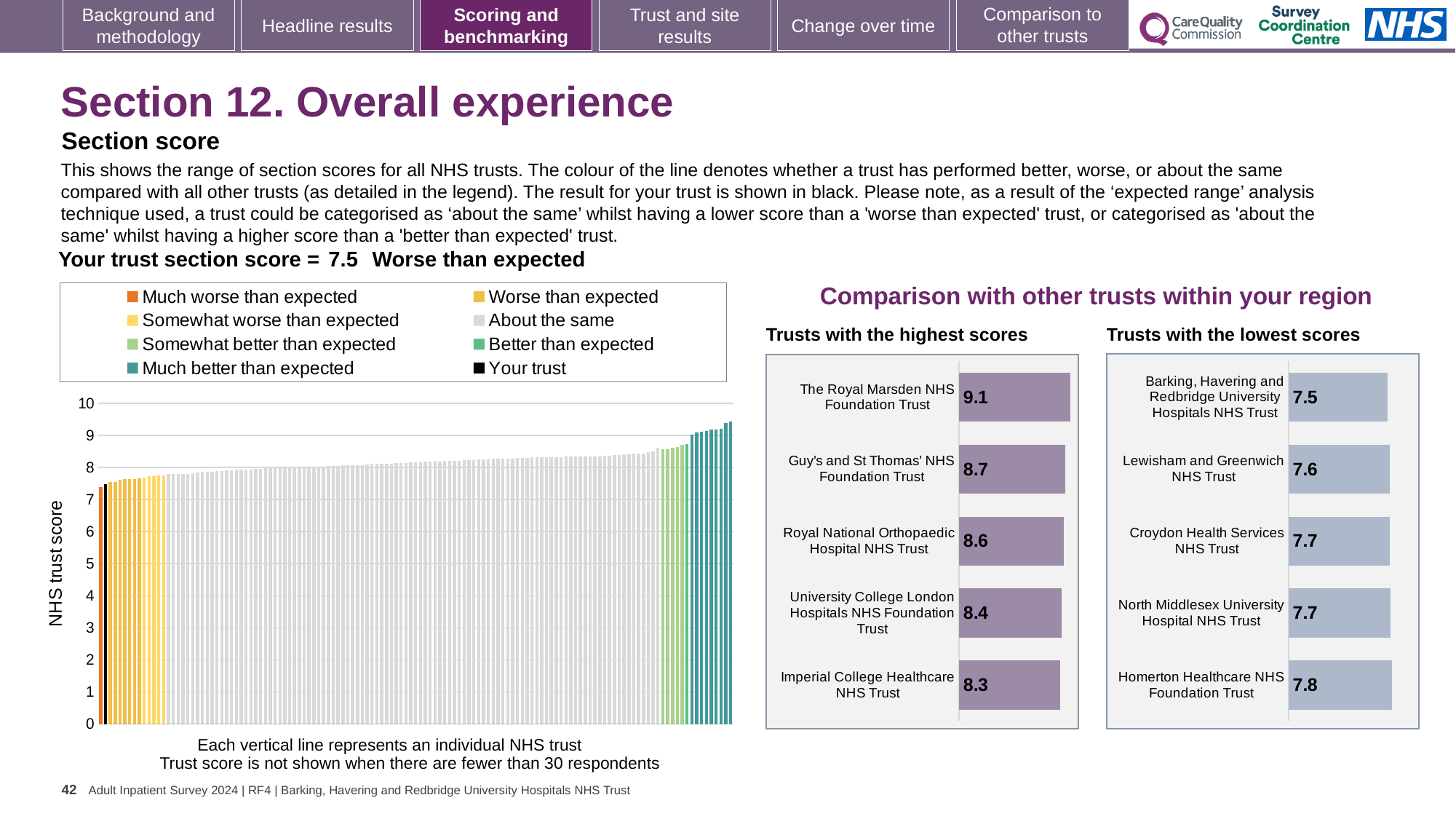
In the 'Trusts with the highest scores' chart, what is the difference between the scores of The Royal Marsden NHS Foundation Trust and Imperial College Healthcare NHS Trust? 0.8 In the 'Trusts with the highest scores' chart, what is the score for The Royal Marsden NHS Foundation Trust? 9.1 How many trusts are shown in the 'Trusts with the lowest scores' chart? 5 What type of chart is the large chart on the left showing NHS trust scores? Bar chart In the 'Trusts with the lowest scores' chart, which trust has the lowest score? Barking, Havering and Redbridge University Hospitals NHS Trust In the 'Trusts with the highest scores' chart, which has the higher score: Guy's and St Thomas' NHS Foundation Trust or Royal National Orthopaedic Hospital NHS Trust? Guy's and St Thomas' NHS Foundation Trust In the large chart on the left, is the value for the black 'Your trust' bar greater or less than 8? less How many entries does the legend of the large chart on the left list? 8 In the 'Trusts with the highest scores' chart, what is the score for Imperial College Healthcare NHS Trust? 8.3 In the 'Trusts with the highest scores' chart, which trust has the highest score? The Royal Marsden NHS Foundation Trust In the 'Trusts with the lowest scores' chart, what is the score for Homerton Healthcare NHS Foundation Trust? 7.8 In the 'Trusts with the lowest scores' chart, what is the difference between the scores of Homerton Healthcare NHS Foundation Trust and Barking, Havering and Redbridge University Hospitals NHS Trust? 0.3